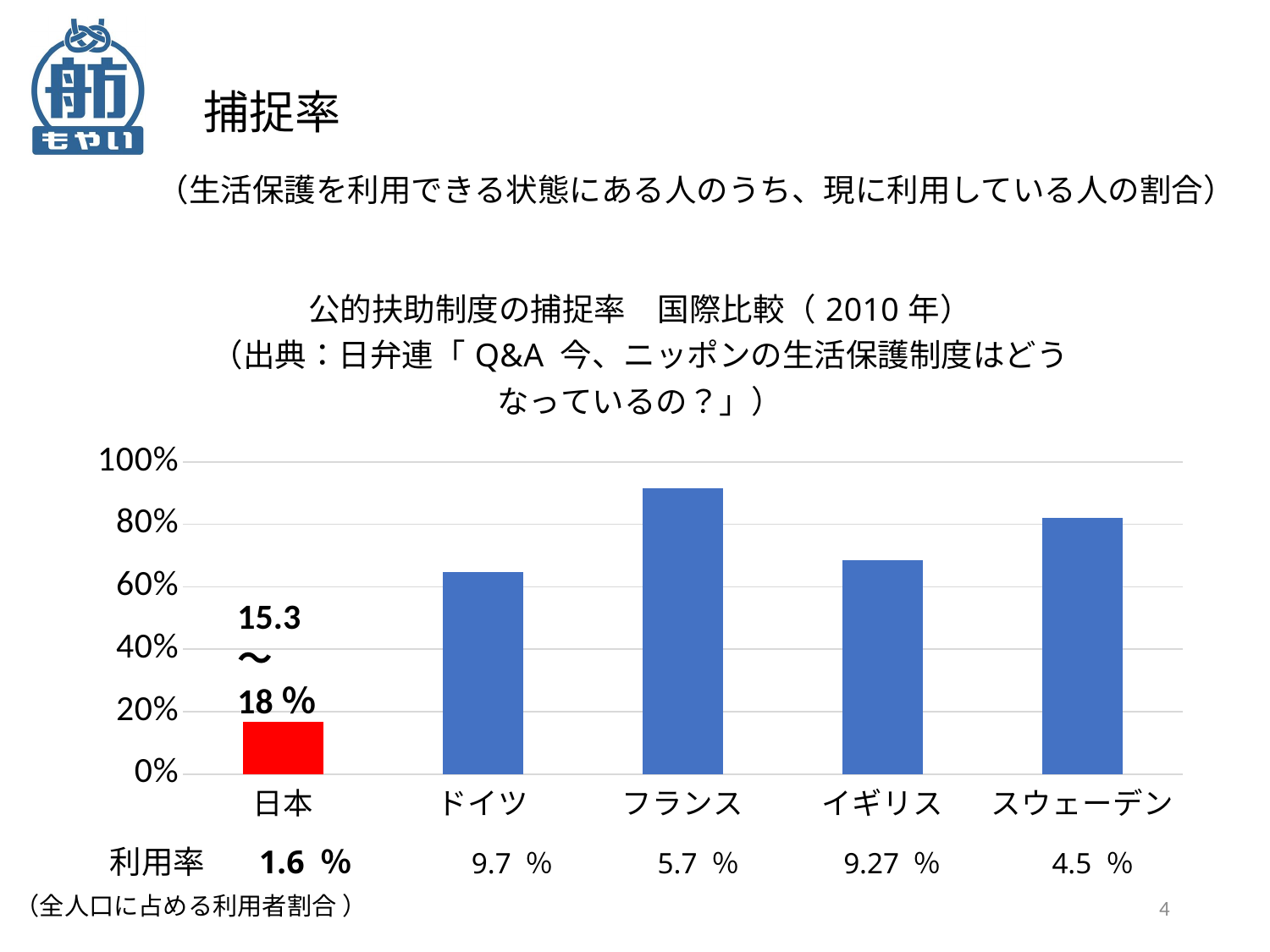
Which country has the highest bar in the chart? フランス How many countries are shown on the x axis of the chart? 5 Which has the larger value, スウェーデン or イギリス? スウェーデン Which year does the chart title say the international comparison is for? 2010年 Is the value for フランス greater or less than 80%? greater Is the value for イギリス greater or less than 80%? less Which country has the lowest bar in the chart? 日本 What value label is printed above the bar for 日本? 15.3〜18％ What kind of chart is shown on the slide? bar chart Is the value for ドイツ greater or less than 60%? greater Which has the larger value, ドイツ or フランス? フランス What colour is the bar for 日本? red